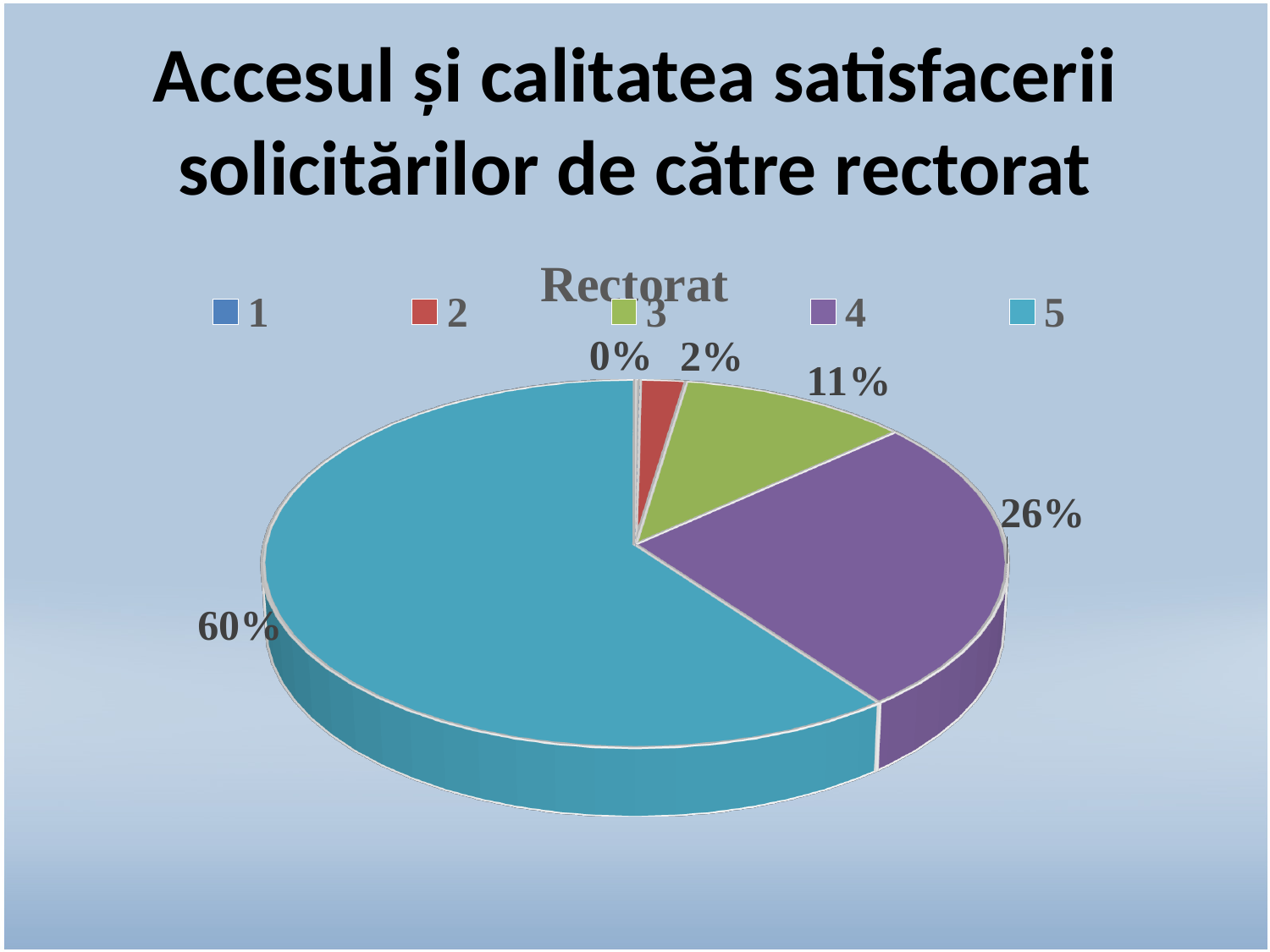
What is the value for category 3? 11% What share of the pie does category 4 have? 26% Which is larger, the value for category 3 or category 4? 4 What share of the pie does category 5 have? 60% What is the difference between the values for category 5 and category 4? 34% What is the chart's title? Rectorat What is the value for category 2? 2% What kind of chart is shown on the slide? pie chart What is the value for category 1? 0% How many categories does the legend list? 5 Which category has the smallest slice? 1 Which category has the largest slice? 5